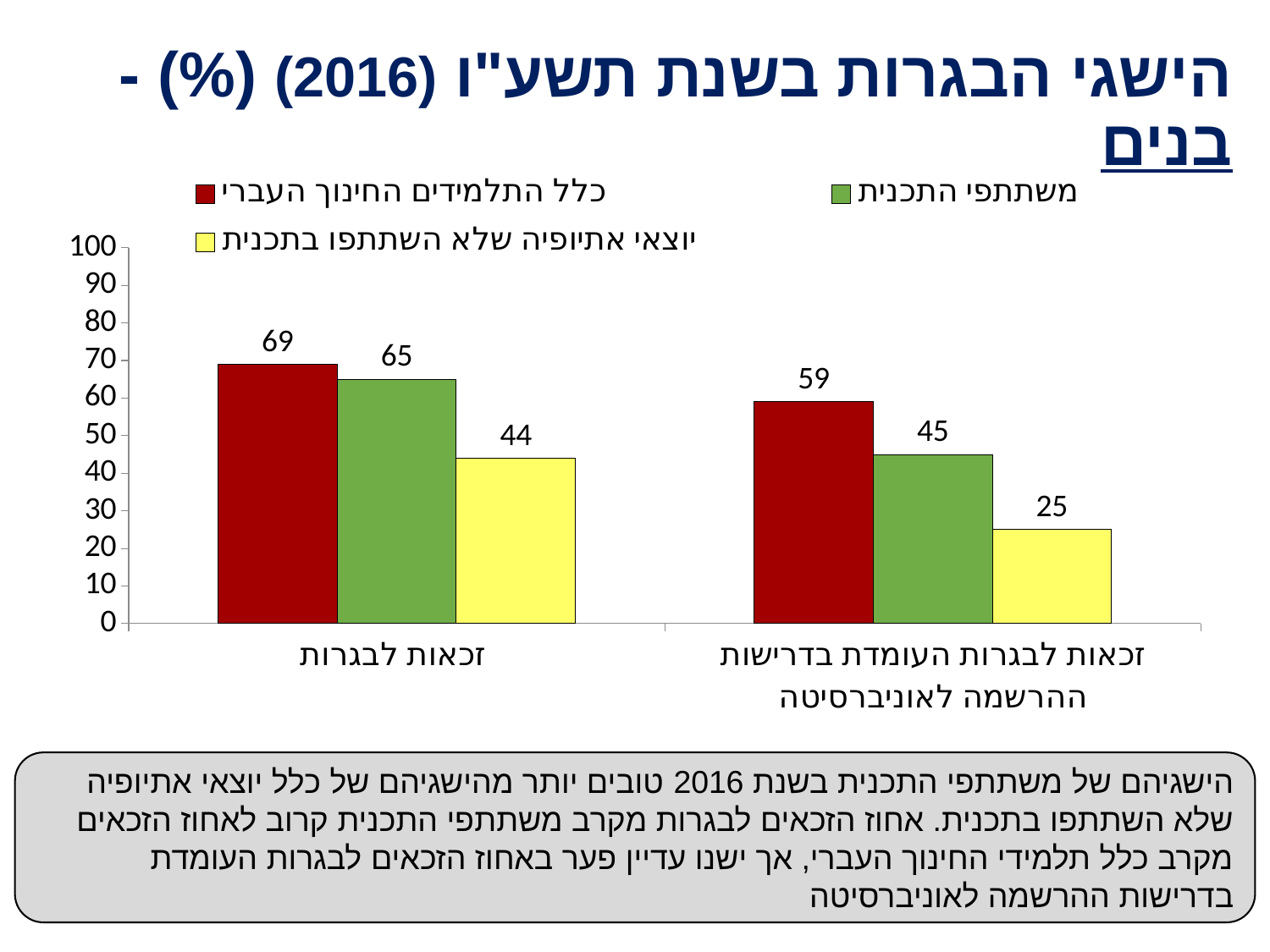
What is the value for כלל התלמידים החינוך העברי in the זכאות לבגרות category? 69 What is the difference between the values for משתתפי התכנית and יוצאי אתיופיה שלא השתתפו בתכנית in the זכאות לבגרות category? 21 Which is larger: the value for משתתפי התכנית in זכאות לבגרות or in זכאות לבגרות העומדת בדרישות ההרשמה לאוניברסיטה? זכאות לבגרות What is the value for משתתפי התכנית in the זכאות לבגרות העומדת בדרישות ההרשמה לאוניברסיטה category? 45 Which series has the lowest value in the זכאות לבגרות category? יוצאי אתיופיה שלא השתתפו בתכנית What is the value for משתתפי התכנית in the זכאות לבגרות category? 65 What is the value for יוצאי אתיופיה שלא השתתפו בתכנית in the זכאות לבגרות העומדת בדרישות ההרשמה לאוניברסיטה category? 25 What is the difference between the values for כלל התלמידים החינוך העברי and משתתפי התכנית in the זכאות לבגרות העומדת בדרישות ההרשמה לאוניברסיטה category? 14 How many categories are shown on the x axis? 2 Which series has the highest value in the זכאות לבגרות העומדת בדרישות ההרשמה לאוניברסיטה category? כלל התלמידים החינוך העברי What kind of chart is shown on the slide? Bar chart How many series does the legend list? 3